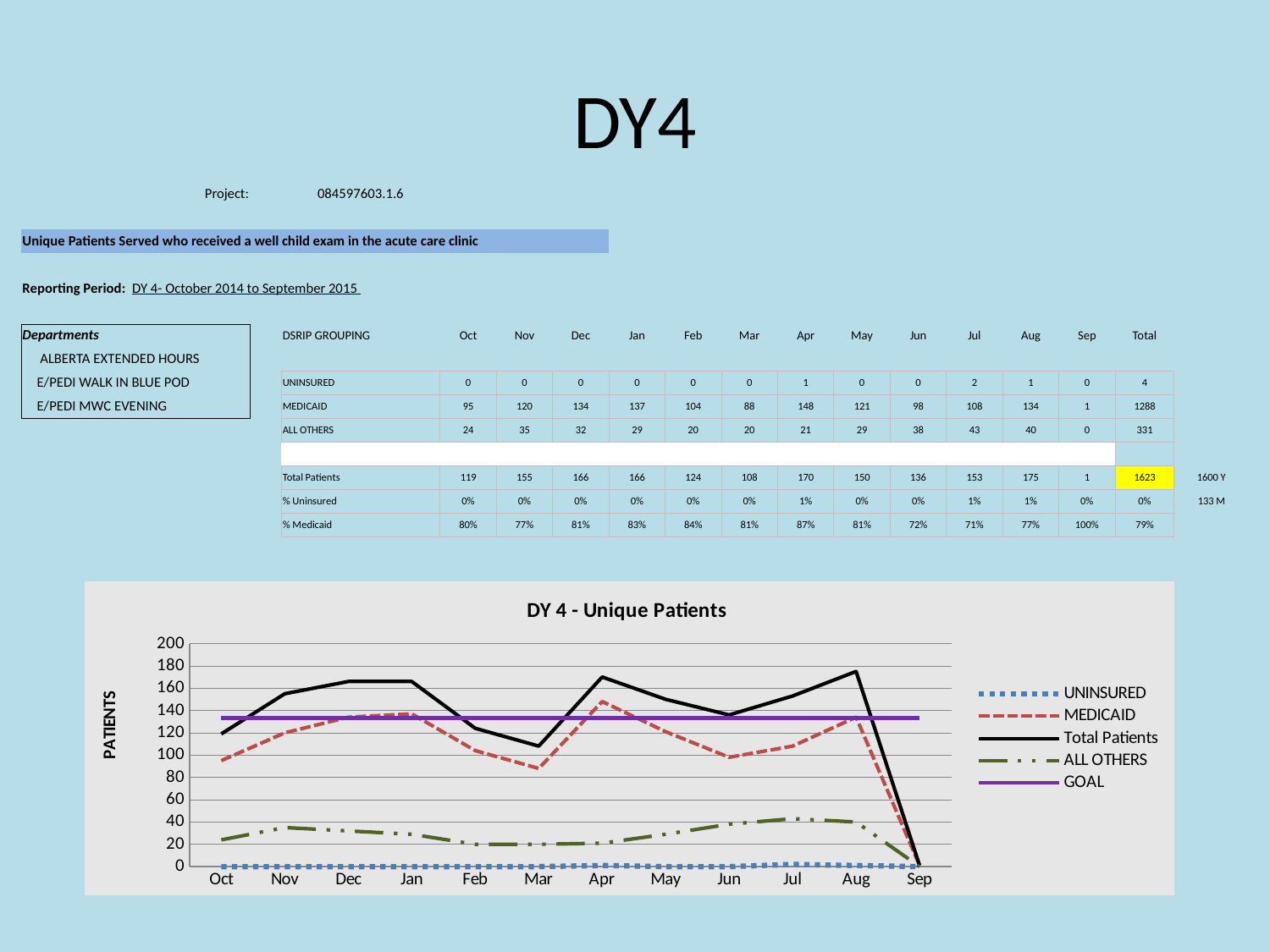
How many months are plotted along the x axis of the DY 4 - Unique Patients chart? 12 What is the difference between the Total Patients values for Dec and Feb? 42 What type of chart is shown on the slide? line chart Is the MEDICAID value for Apr greater or less than 140? greater Does the Total Patients line rise or fall from Jan to Mar? fall In which month is the Total Patients line at its highest? Aug In which month is the Total Patients line at its lowest? Sep What is the title of the chart on the slide? DY 4 - Unique Patients Which month has the larger Total Patients value, Nov or Feb? Nov Is the Total Patients value for Mar greater or less than 120? less What is the Total Patients value for Aug? 175 How many series does the legend of the DY 4 - Unique Patients chart list? 5